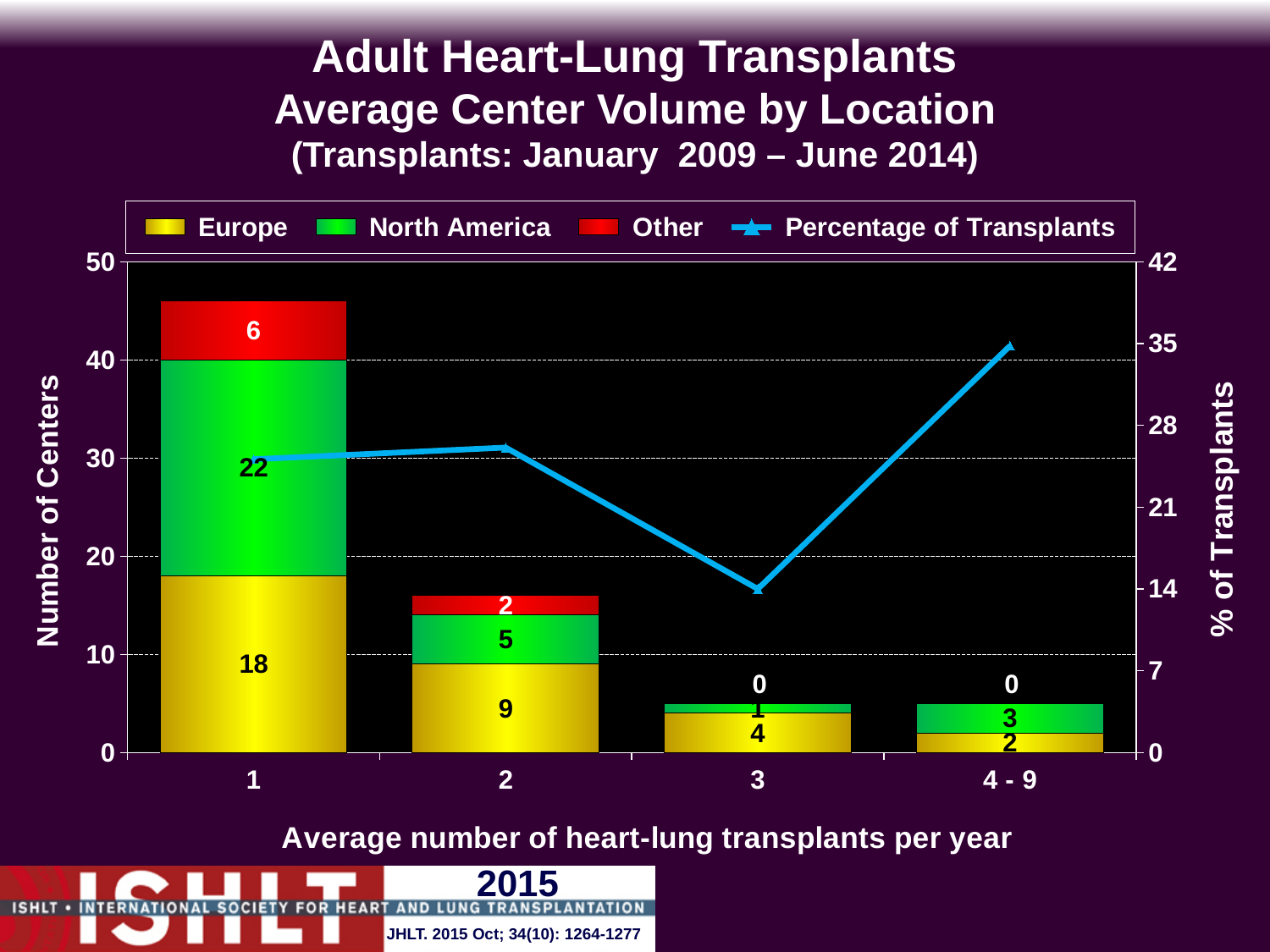
What is the difference between the North America and Europe values at an average of 1 transplant per year? 4 How many series does the legend list? 4 What is the total number of centers in the stacked bar for an average of 2 transplants per year? 16 Is the Percentage of Transplants value for the category 4 - 9 greater or less than 28? greater What is the value for Europe at an average of 1 heart-lung transplant per year? 18 What is the value for Other at an average of 1 heart-lung transplant per year? 6 What kind of chart is shown on the slide? A stacked bar chart with a line Is the Percentage of Transplants value for the category 3 greater or less than 21? less What is the total number of centers in the stacked bar for an average of 1 transplant per year? 46 What is the value for North America at an average of 2 heart-lung transplants per year? 5 How many categories are shown on the x axis? 4 Which category has the highest total number of centers? 1